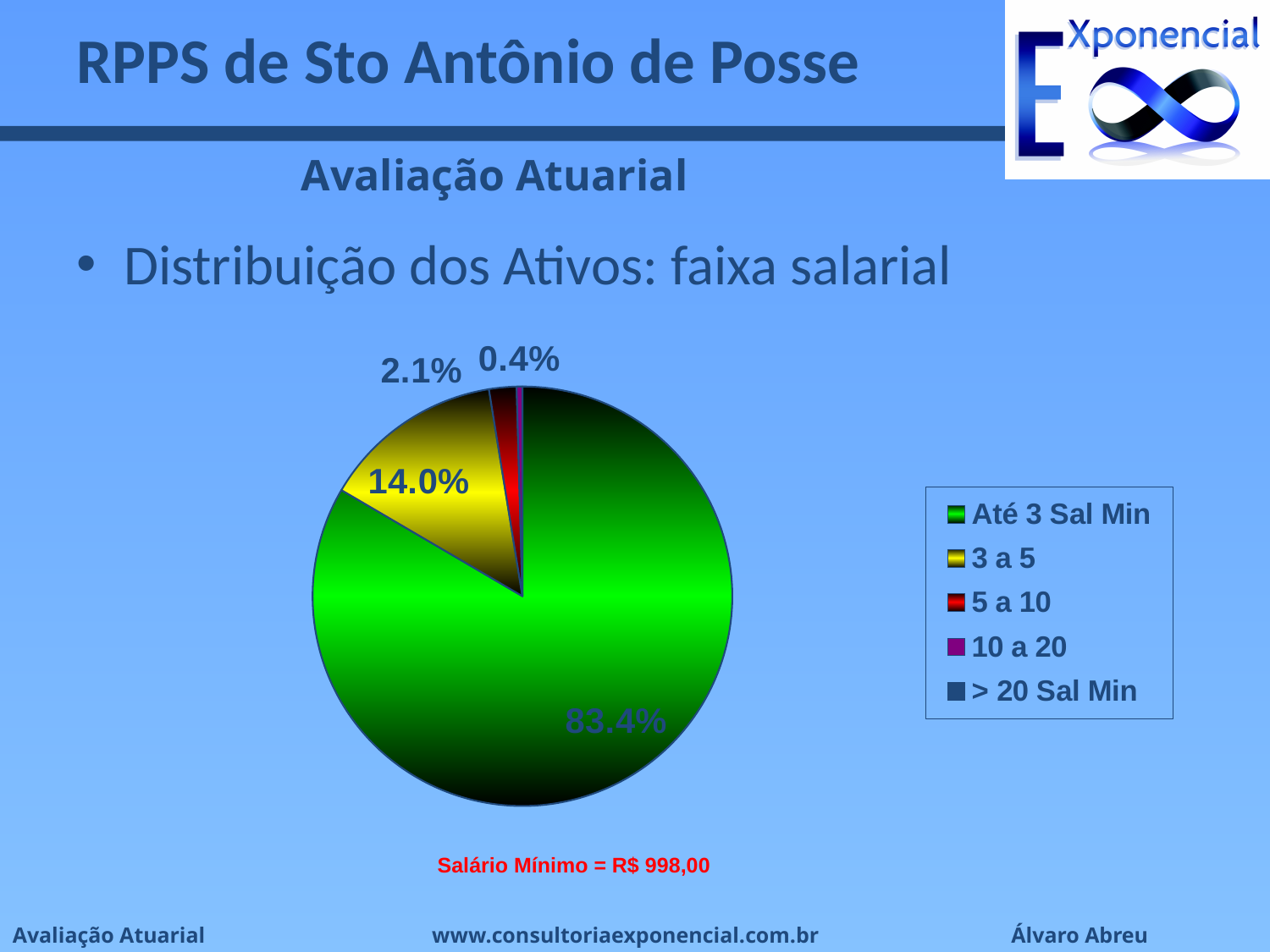
Which slice is larger, "5 a 10" or "10 a 20"? 5 a 10 How many categories does the legend list? 5 What kind of chart is shown on the slide? Pie chart What is the difference in percentage points between the "Até 3 Sal Min" slice and the "3 a 5" slice? 69.4 What share of the pie does the "5 a 10" slice represent? 2.1% What colour is the "3 a 5" slice in the pie chart? Yellow What share of the pie does the "Até 3 Sal Min" slice represent? 83.4% What is the difference in percentage points between the "3 a 5" slice and the "5 a 10" slice? 11.9 What share of the pie does the "3 a 5" slice represent? 14.0% Which slice is larger, "3 a 5" or "5 a 10"? 3 a 5 What share of the pie does the "10 a 20" slice represent? 0.4% Which salary band has the largest share of the pie? Até 3 Sal Min